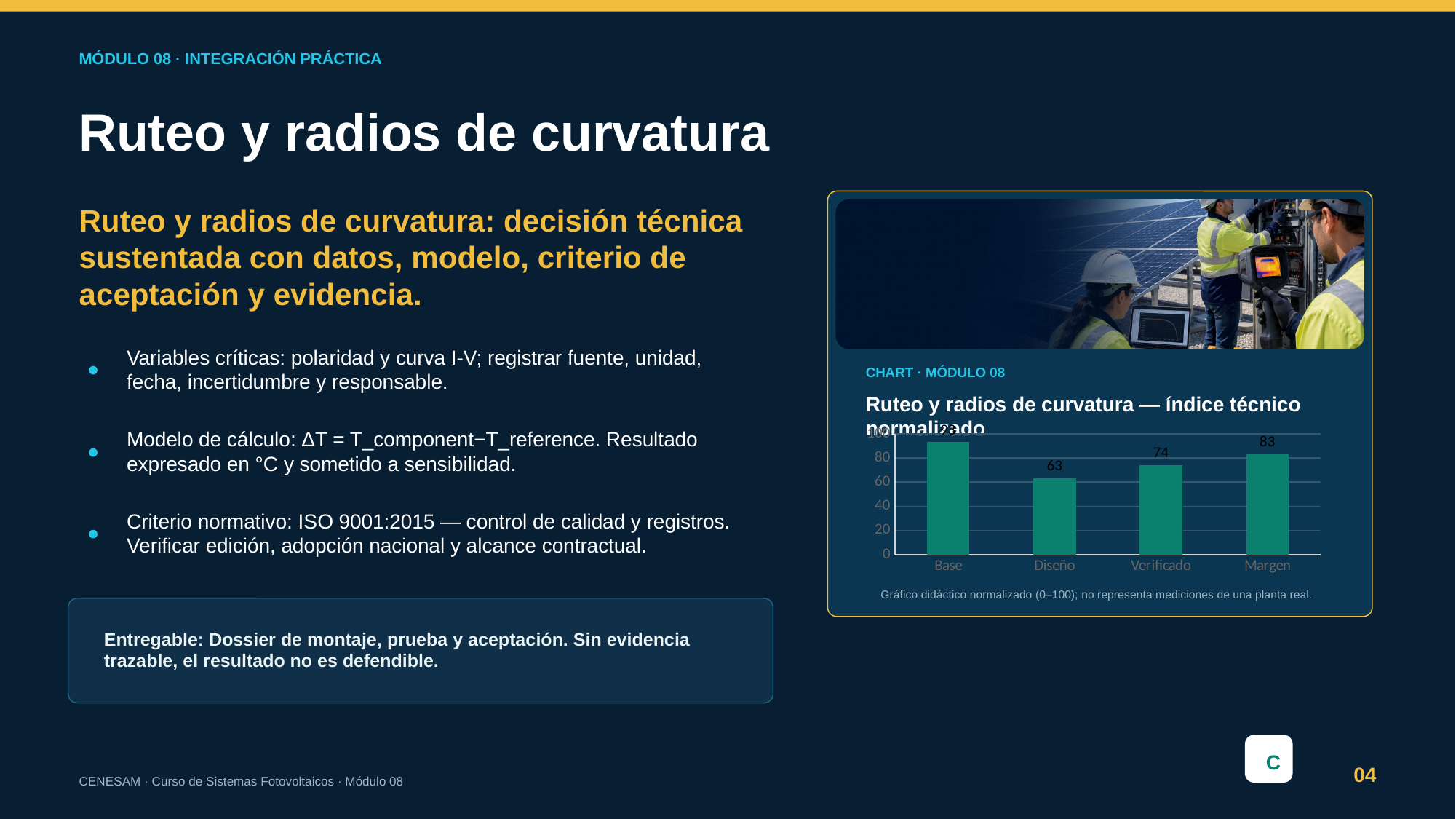
What is the difference between the values for Margen and Diseño? 20 What is the difference between the values for Margen and Verificado? 9 Is the value for Base greater or less than 80? greater What is the value for Verificado in the chart? 74 What kind of chart is shown on the slide? bar chart What is the value for Diseño in the chart? 63 Which is larger, the value for Verificado or the value for Diseño? Verificado How many categories are shown on the x axis of the chart? 4 Which category has the lowest value in the chart? Diseño Which category has the highest value in the chart? Base What is the value for Margen in the chart? 83 What is the title of the chart? Ruteo y radios de curvatura — índice técnico normalizado